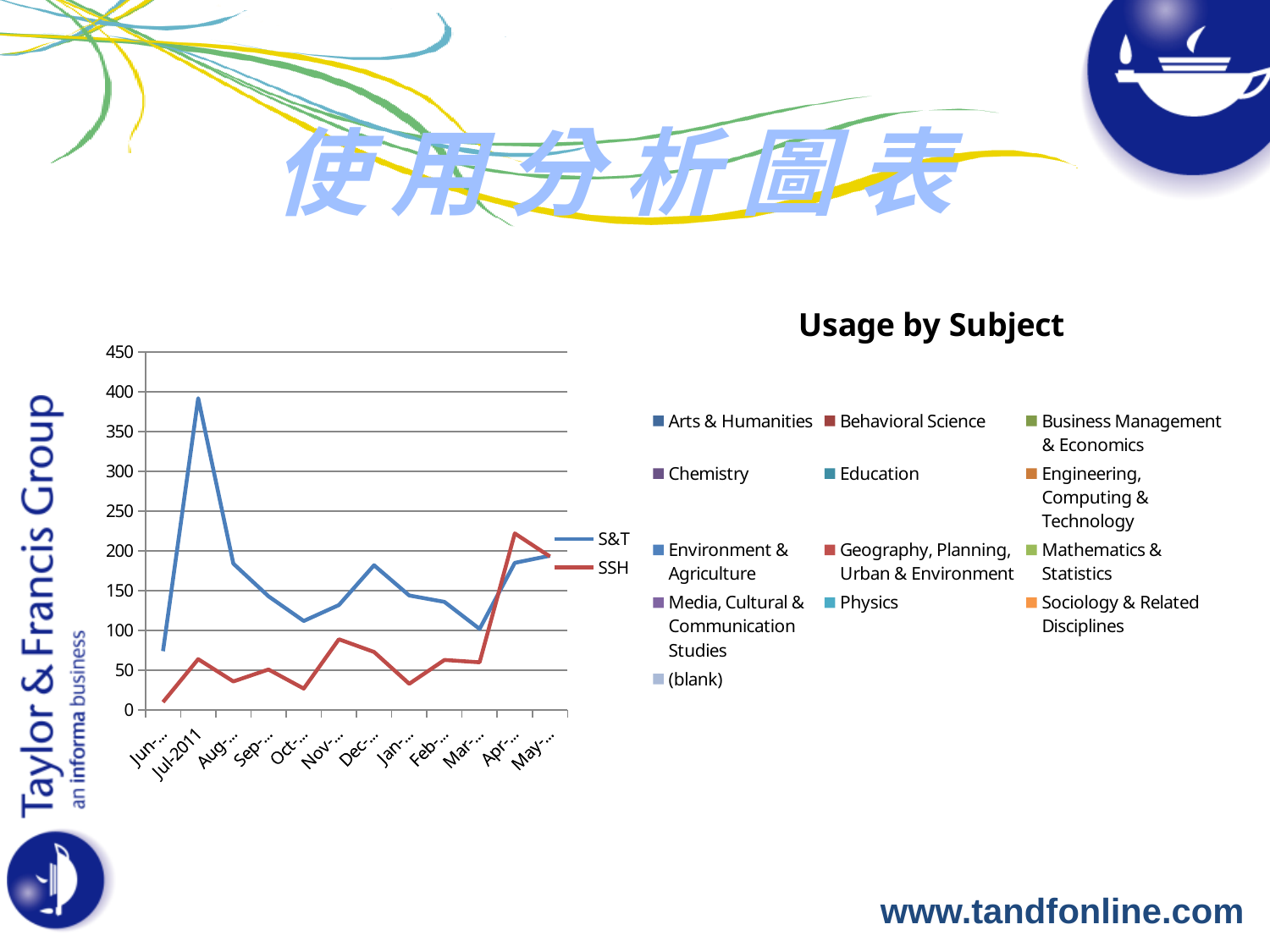
In the line chart on the left, does the S&T series rise or fall from Jul-2011 to Oct? fall What kind of chart is the chart on the left of the slide? line chart In the line chart on the left, is the SSH value for Apr greater or less than 200? greater In the line chart on the left, in which month does the S&T series reach its highest value? Jul-2011 In the line chart on the left, how many months are plotted along the x axis? 12 In the line chart on the left, how many series does the legend list? 2 In the line chart on the left, which series has the larger value in Jul-2011, S&T or SSH? S&T In the line chart on the left, in which month is the SSH series at its lowest? Jun In the line chart on the left, is the SSH value for Jul-2011 greater or less than 100? less In the line chart on the left, which series has the larger value in Apr, S&T or SSH? SSH What is the title of the chart on the right of the slide? Usage by Subject In the line chart on the left, is the S&T value for Jul-2011 greater or less than 350? greater